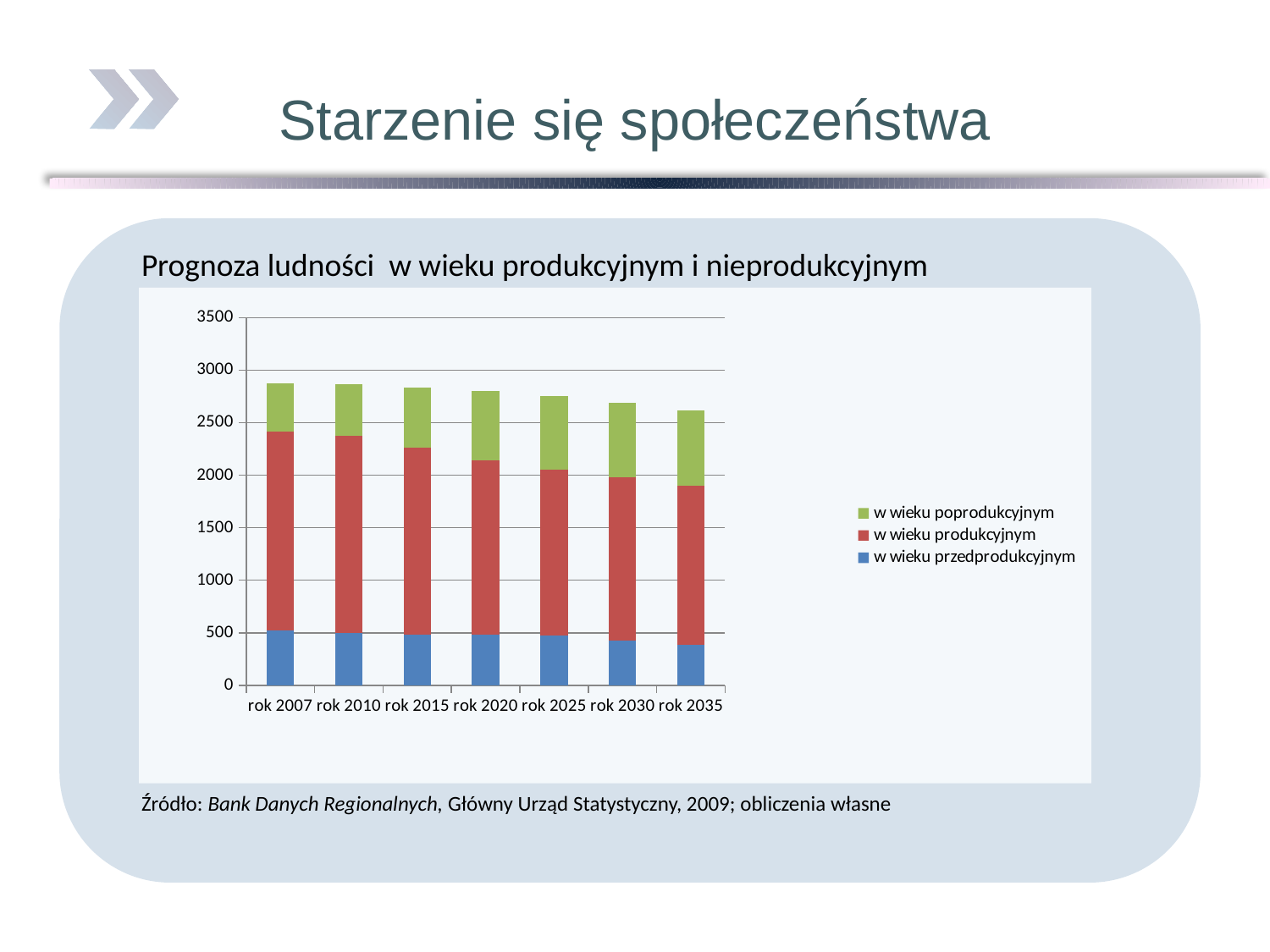
Is the total bar height for rok 2007 greater or less than 2500? greater What kind of chart is shown on the slide? stacked bar chart Is the top of the 'w wieku produkcyjnym' segment for rok 2020 above or below 2000 on the axis? above What is the title above the chart? Prognoza ludności w wieku produkcyjnym i nieprodukcyjnym How many series does the chart's legend list? 3 Is the 'w wieku przedprodukcyjnym' segment for rok 2035 greater or less than 500? less Which year has the lowest total bar height in the chart? rok 2035 How many years (categories) are shown on the x axis of the chart? 7 Do the total bar heights rise or fall from rok 2007 to rok 2035? fall Which total bar is taller, rok 2007 or rok 2035? rok 2007 Which series is shown in green in the chart's legend? w wieku poprodukcyjnym